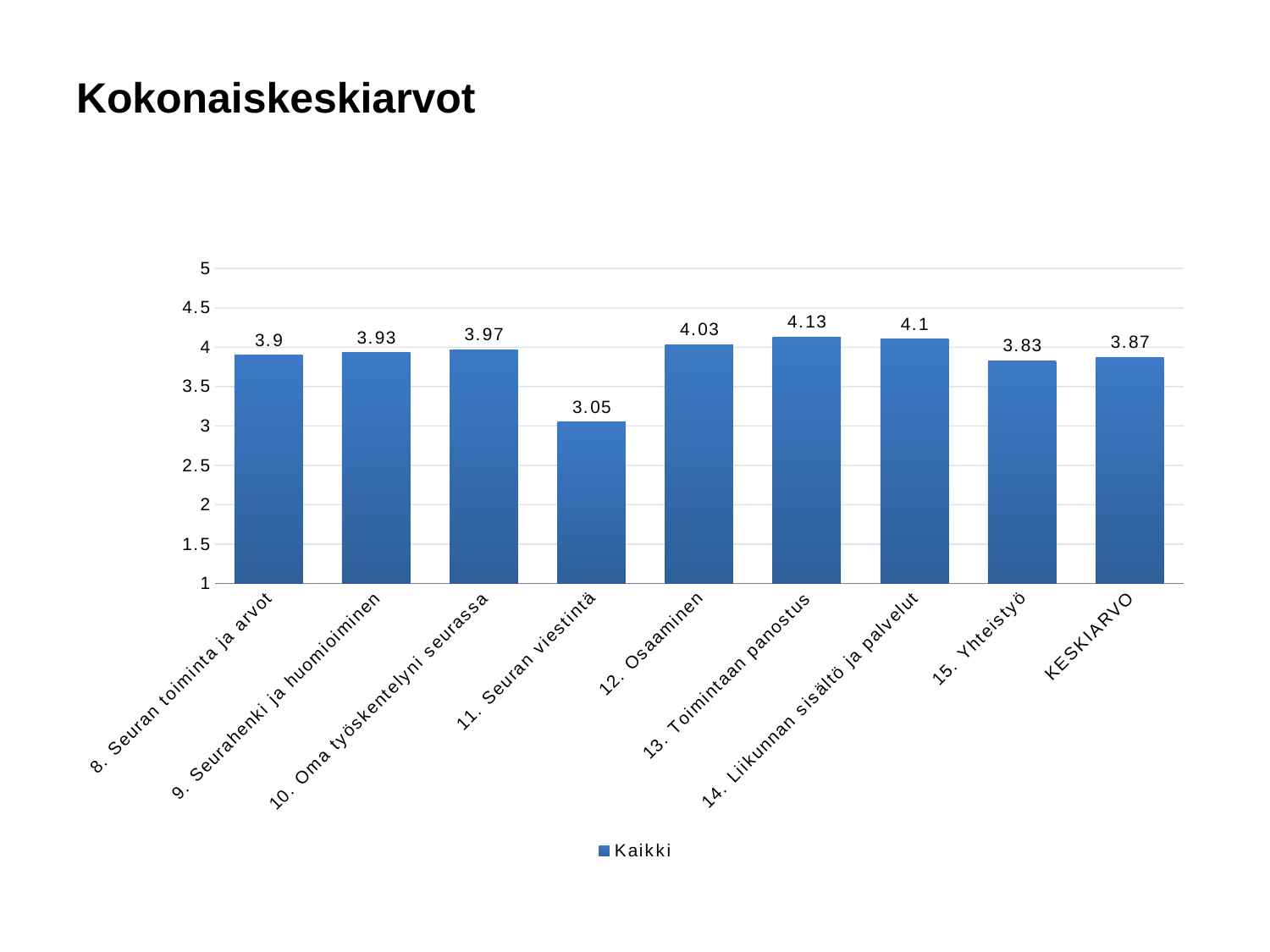
What is the value for "13. Toimintaan panostus"? 4.13 Which category has the lowest value? 11. Seuran viestintä What is the value for KESKIARVO? 3.87 How many categories are shown on the x axis? 9 Is the value for "14. Liikunnan sisältö ja palvelut" greater or less than 4? greater Which category has the highest value? 13. Toimintaan panostus What kind of chart is shown on the slide? bar chart What is the value for "11. Seuran viestintä"? 3.05 Which is larger, the value for "12. Osaaminen" or the value for "15. Yhteistyö"? 12. Osaaminen What is the title of the slide? Kokonaiskeskiarvot What is the difference between the values for "13. Toimintaan panostus" and "11. Seuran viestintä"? 1.08 How many series does the legend list? 1